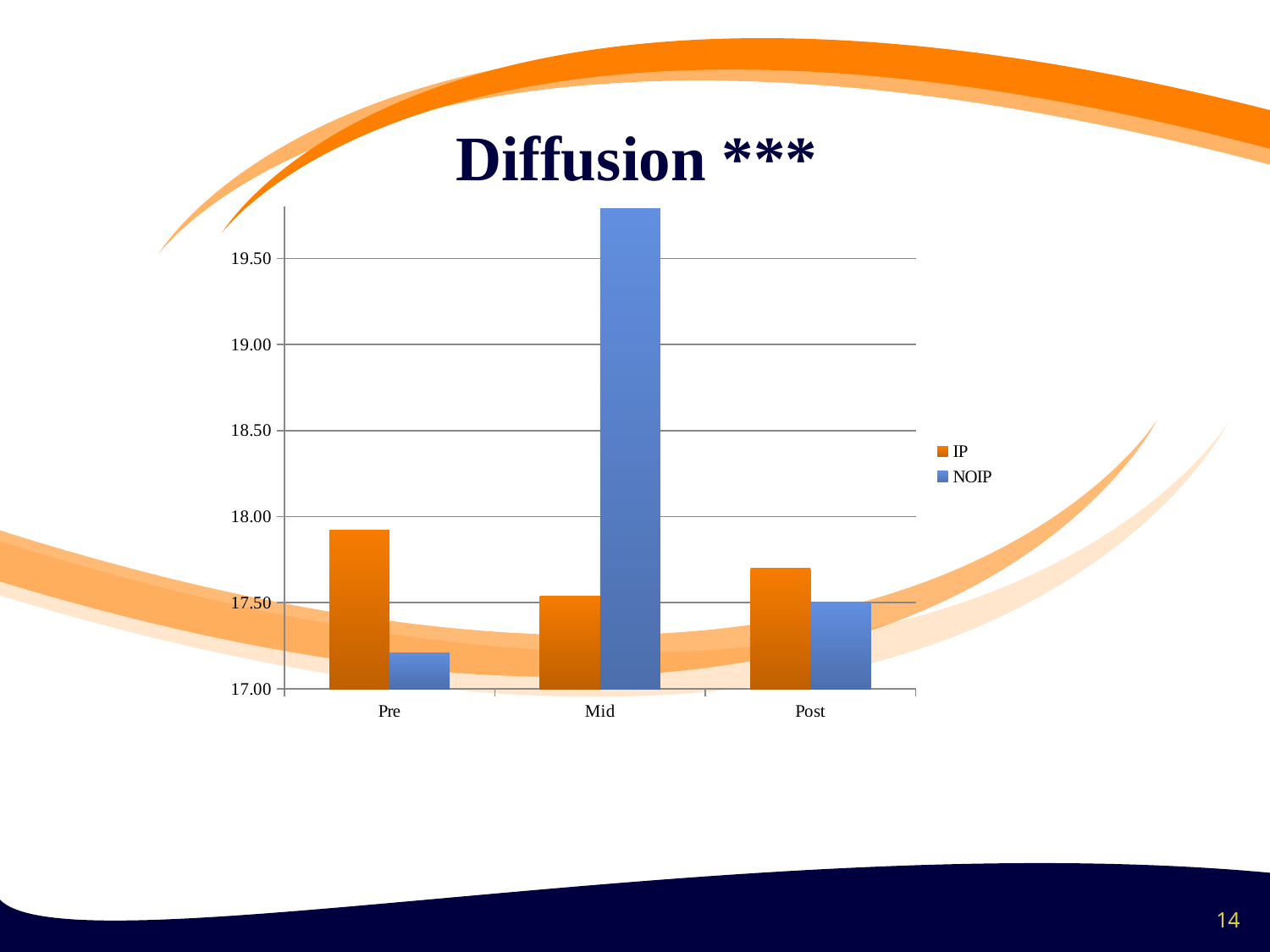
At which category is the NOIP value highest? Mid At which category is the NOIP value lowest? Pre How many series does the legend list? 2 At which category is the IP value highest? Pre What kind of chart is shown on the slide? bar chart Is the NOIP value at Pre greater or less than 17.50? less How many categories are shown on the x axis? 3 Which colour represents the NOIP series? blue At Pre, which series has the larger value, IP or NOIP? IP Is the NOIP value at Mid greater or less than 19.50? greater At Mid, which series has the larger value, IP or NOIP? NOIP What is the title of the chart? Diffusion ***